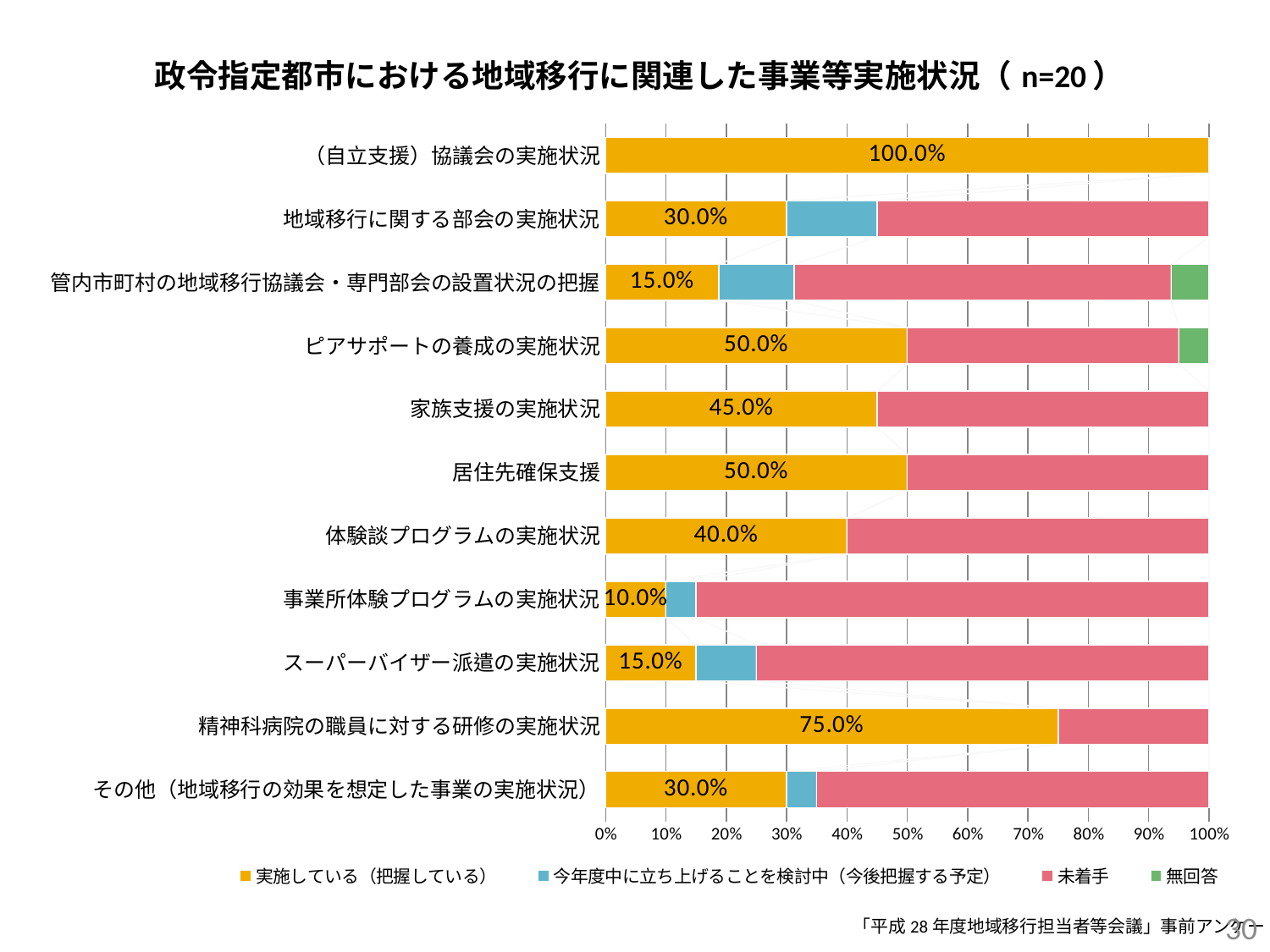
What is the 実施している（把握している） value for 家族支援の実施状況? 45.0% Is the 未着手 share for 事業所体験プログラムの実施状況 greater or less than 80%? greater Which category has the highest 実施している（把握している） value? （自立支援）協議会の実施状況 What is the 実施している（把握している） value for 精神科病院の職員に対する研修の実施状況? 75.0% What is the 実施している（把握している） value for 管内市町村の地域移行協議会・専門部会の設置状況の把握? 15.0% Which has the larger 実施している（把握している） value: 体験談プログラムの実施状況 or 居住先確保支援? 居住先確保支援 What is the difference between the 実施している（把握している） values for 精神科病院の職員に対する研修の実施状況 and 家族支援の実施状況? 30.0% How many series does the legend list? 4 Which category has the lowest 実施している（把握している） value? 事業所体験プログラムの実施状況 What type of chart is shown on the slide? Stacked bar chart What sample size (n) is stated in the chart title? n=20 How many categories (rows) are plotted in the chart? 11